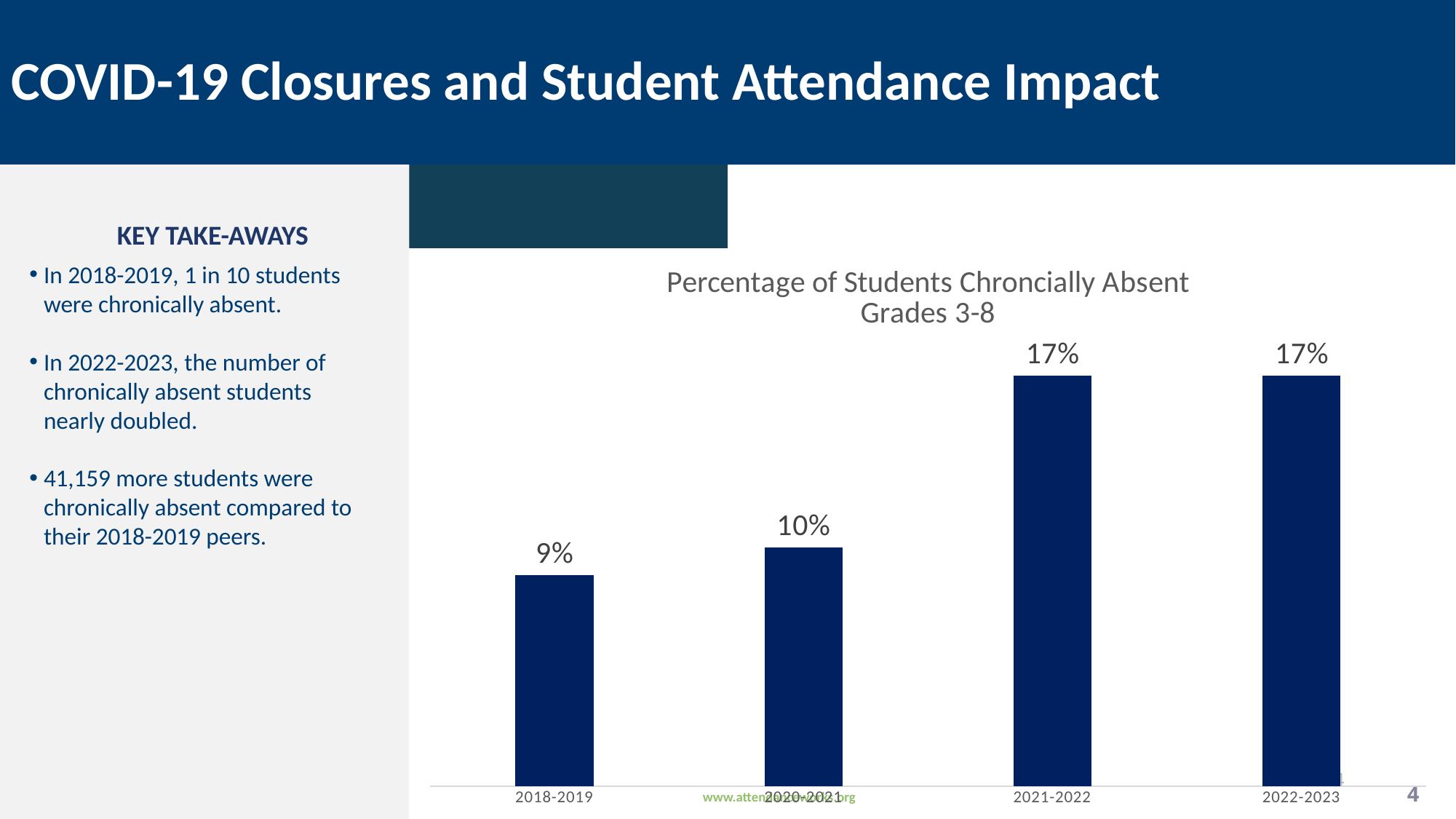
What is the difference between the values for 2021-2022 and 2020-2021? 7 percentage points What is the title of the chart? Percentage of Students Chroncially Absent Grades 3-8 What is the value for 2021-2022 in the chart? 17% How many school years are shown in the chart? 4 Which is larger, the value for 2020-2021 or the value for 2021-2022? 2021-2022 What kind of chart is shown on the slide? Bar chart Which school year has the lowest percentage of students chronically absent? 2018-2019 What is the value for 2020-2021 in the chart? 10% What is the difference between the values for 2022-2023 and 2018-2019? 8 percentage points Do the values rise or fall from 2018-2019 to 2022-2023? Rise What is the value for 2018-2019 in the chart? 9% What is the value for 2022-2023 in the chart? 17%